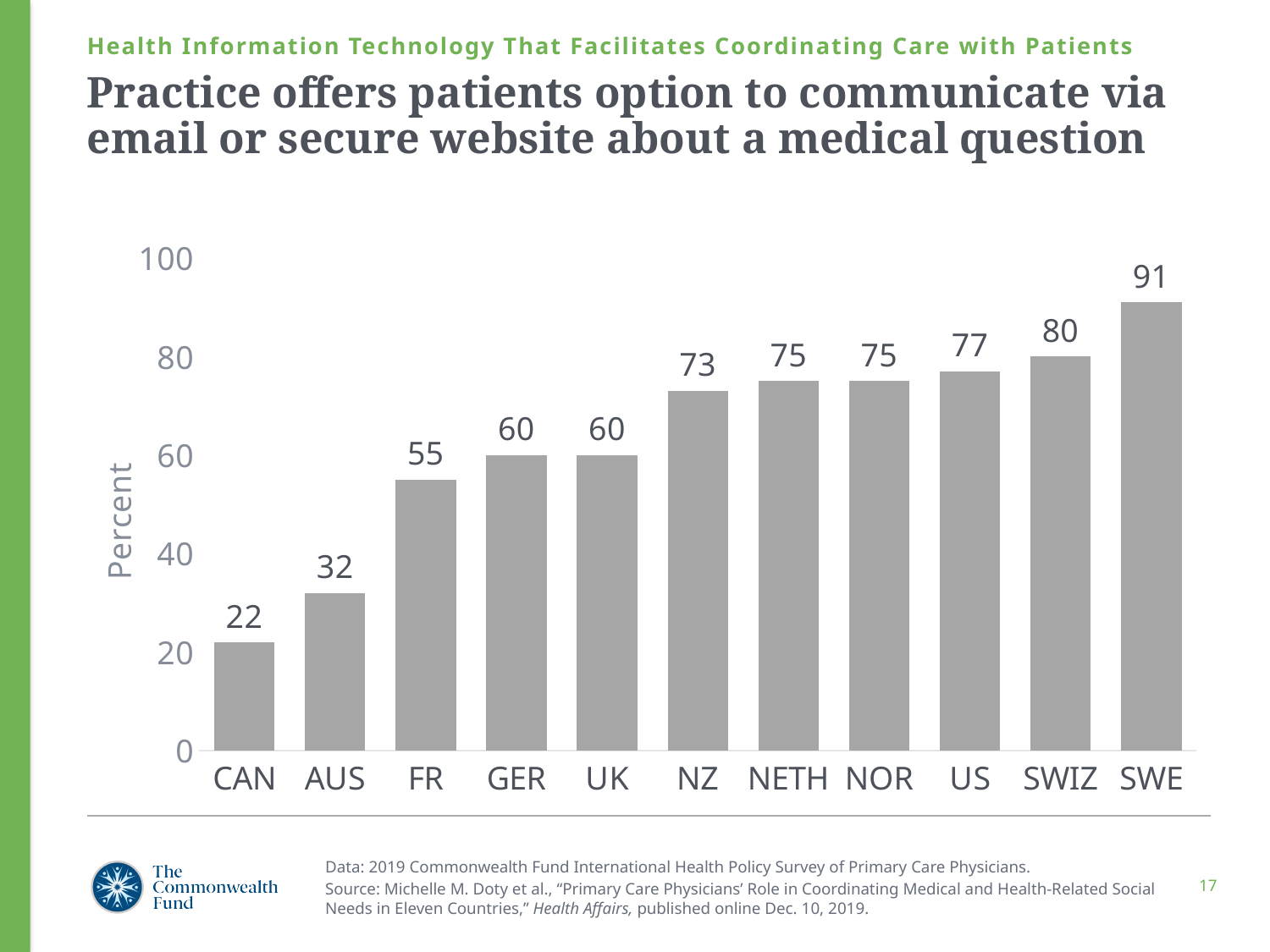
What is the difference between the values for SWE and CAN? 69 What is the value for SWIZ? 80 What kind of chart is this? bar chart What is the value for NZ? 73 What is the difference between the values for US and AUS? 45 What is the value for CAN? 22 Which country has the lowest value? CAN How many countries are shown on the x axis? 11 Which country has the highest value? SWE What is the label on the y axis? Percent Which is larger, the value for FR or the value for GER? GER Do the values rise or fall from CAN to SWE along the x axis? rise